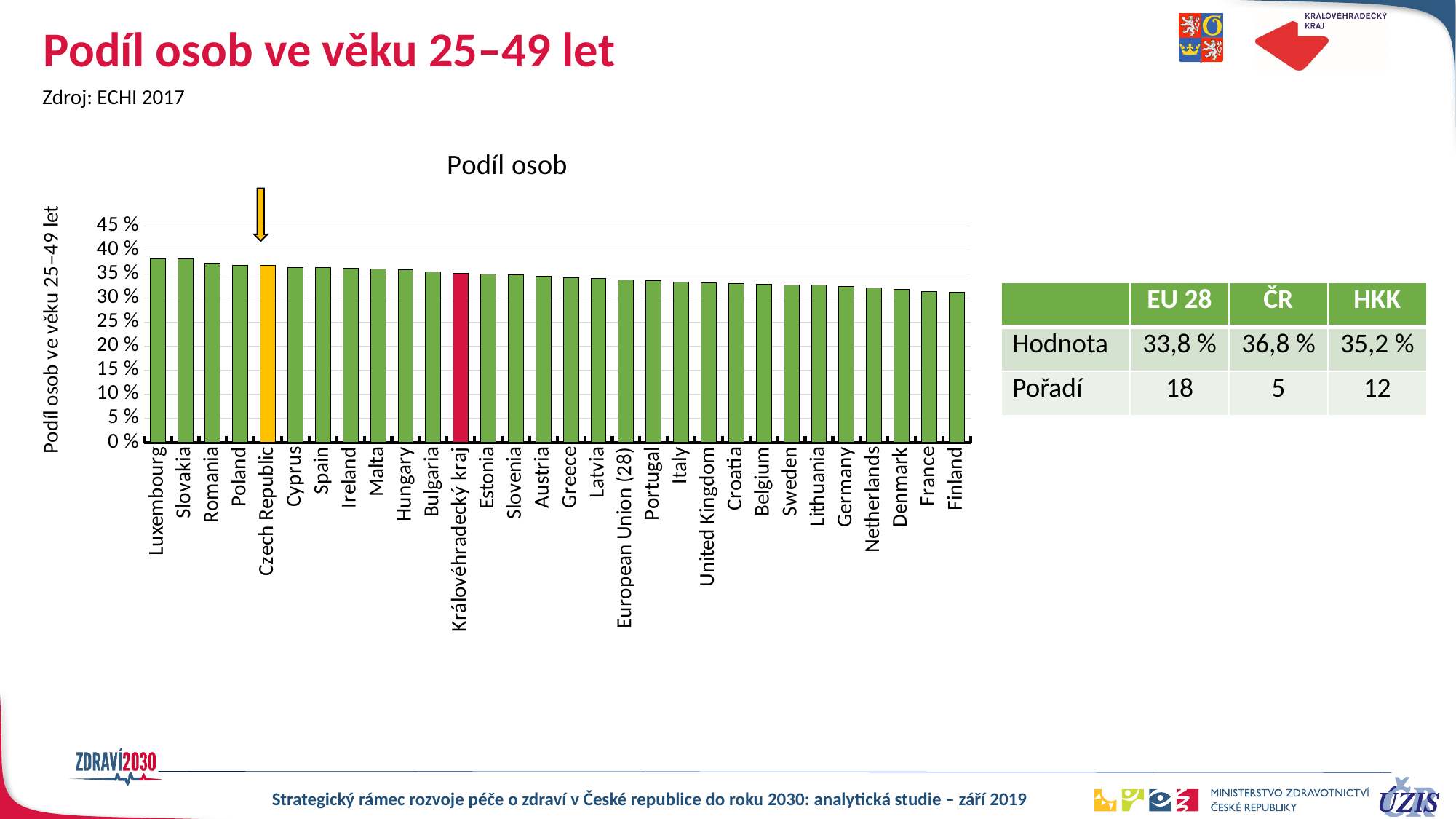
Which has the larger value, Luxembourg or Finland? Luxembourg What kind of chart is shown on the slide? bar chart What is the value for EU 28 according to the table? 33,8 % What is the difference between the value for ČR and the value for EU 28? 3,0 % How many categories (bars) are plotted in the chart? 30 What is the difference between the value for ČR and the value for HKK? 1,6 % What is the value for Královéhradecký kraj (HKK) according to the table? 35,2 % What is the value for the Czech Republic (ČR) according to the table? 36,8 % What is the title of the chart? Podíl osob Do the bar values rise or fall from left to right along the x axis? fall Is the value for Finland greater or less than 35 %? less Is the value for Luxembourg greater or less than 35 %? greater